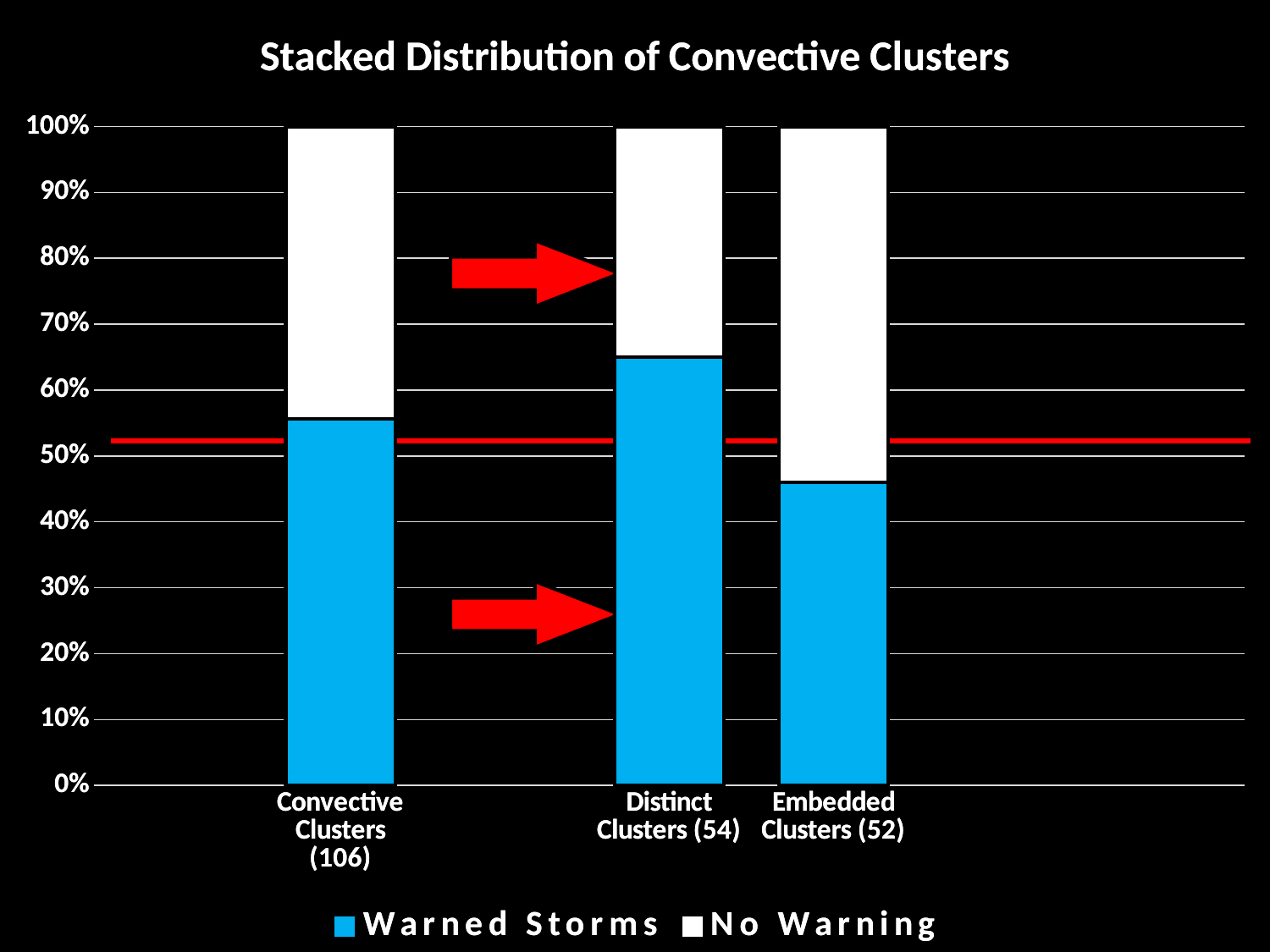
Is the Warned Storms share for Distinct Clusters (54) greater or less than 60%? greater What kind of chart is shown on the slide? Stacked bar chart Which has a larger Warned Storms share, Distinct Clusters (54) or Embedded Clusters (52)? Distinct Clusters (54) Which category has the largest Warned Storms share? Distinct Clusters (54) Which category has the smallest Warned Storms share? Embedded Clusters (52) What is the title of the chart? Stacked Distribution of Convective Clusters What is the total height of each stacked bar? 100% How many categories are shown on the x axis? 3 Is the Warned Storms share for Embedded Clusters (52) greater or less than 50%? less Which series is shown in blue? Warned Storms How many series does the legend list? 2 Is the Warned Storms share for Convective Clusters (106) greater or less than 50%? greater